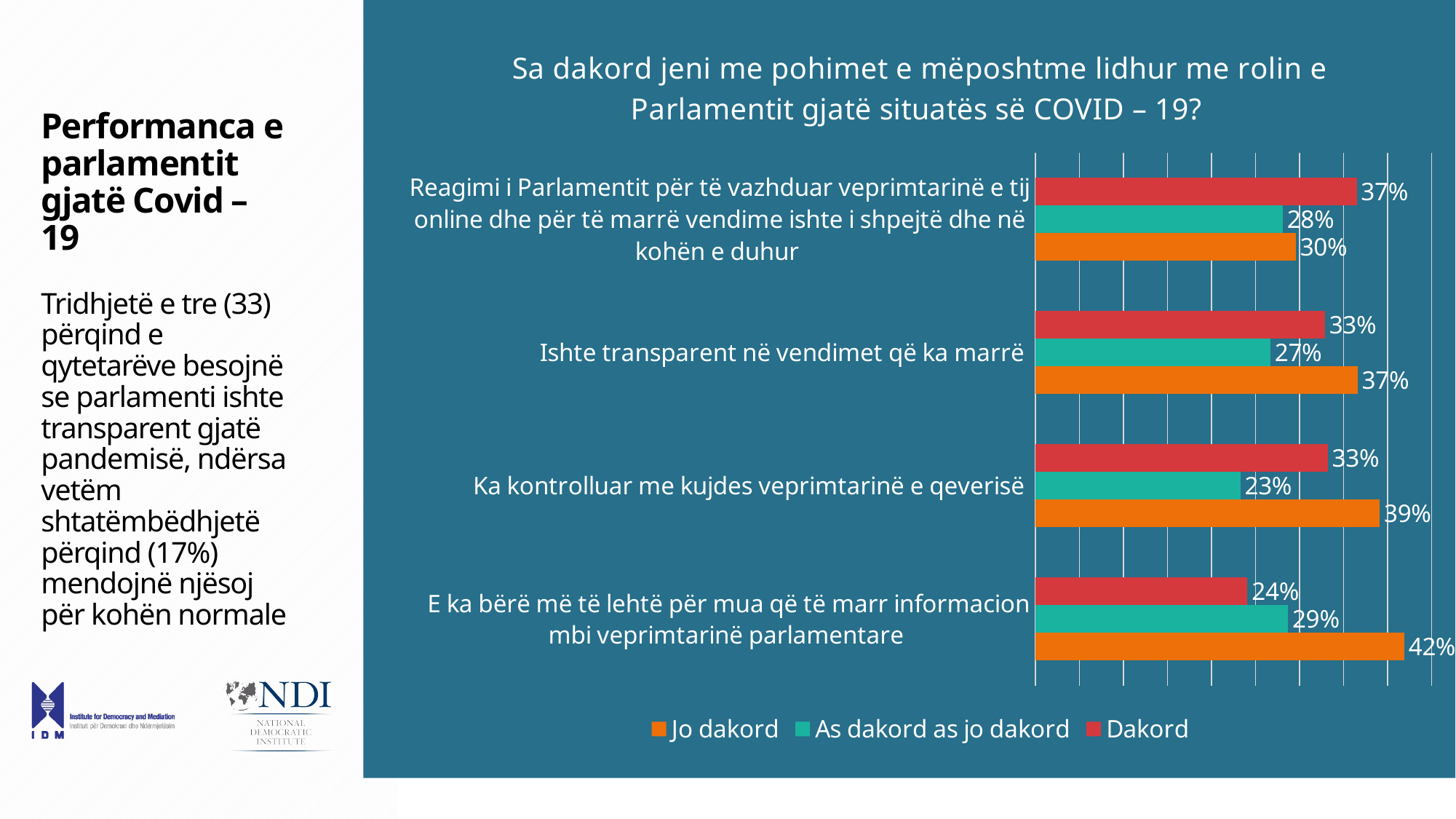
What is the "As dakord as jo dakord" value for "Ka kontrolluar me kujdes veprimtarinë e qeverisë"? 23% Which colour represents "Jo dakord" in the chart? Orange What kind of chart is shown on the slide? Bar chart What percentage of respondents answered "Dakord" for the statement "Ishte transparent në vendimet që ka marrë"? 33% How many series does the legend list? 3 What is the "Dakord" value for "Reagimi i Parlamentit për të vazhduar veprimtarinë e tij online dhe për të marrë vendime ishte i shpejtë dhe në kohën e duhur"? 37% For the statement "Reagimi i Parlamentit për të vazhduar veprimtarinë e tij online...", which is larger: "Dakord" or "Jo dakord"? Dakord What is the "Jo dakord" value for "E ka bërë më të lehtë për mua që të marr informacion mbi veprimtarinë parlamentare"? 42% What is the difference between the "Jo dakord" and "Dakord" values for "Ka kontrolluar me kujdes veprimtarinë e qeverisë"? 6% Which statement has the highest "Jo dakord" value? E ka bërë më të lehtë për mua që të marr informacion mbi veprimtarinë parlamentare How many statements (categories) are shown in the chart? 4 Which statement has the lowest "Dakord" value? E ka bërë më të lehtë për mua që të marr informacion mbi veprimtarinë parlamentare